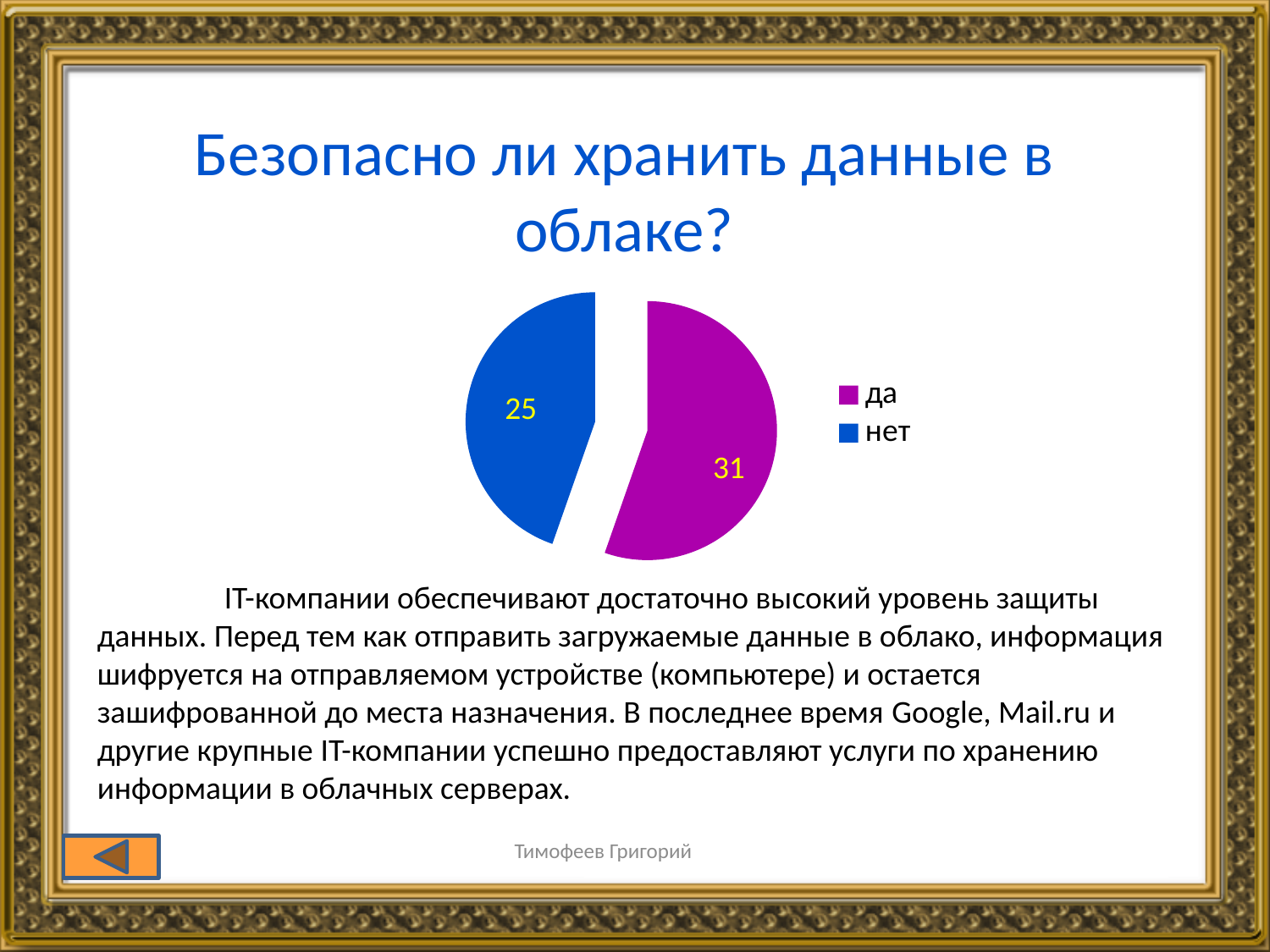
What is the total of the two slices in the pie chart? 56 What is the value for "нет" in the pie chart? 25 How many entries does the legend list? 2 What colour is the slice for "да"? purple What colour is the slice for "нет"? blue Which category has the largest slice in the pie chart? да Which is larger, the value for "да" or the value for "нет"? да What is the difference between the values for "да" and "нет"? 6 How many categories does the pie chart have? 2 What is the value for "да" in the pie chart? 31 What kind of chart is shown on the slide? pie chart Which category has the smallest slice in the pie chart? нет